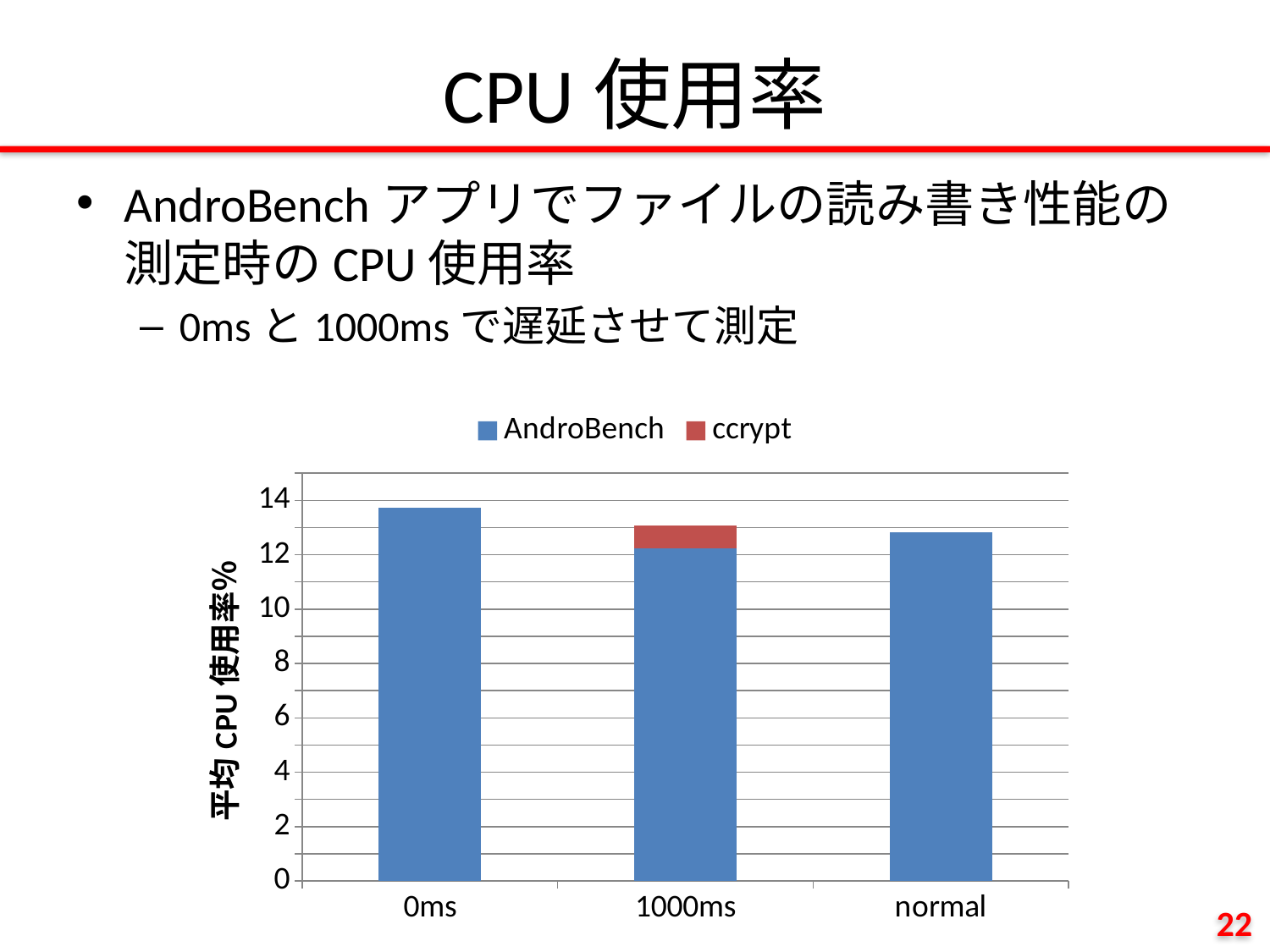
How many categories are shown on the x axis of the chart? 3 Is the AndroBench value for normal greater or less than 14? less Is the AndroBench value for 1000ms greater or less than 10? greater In which category is a ccrypt segment visible in the stacked bar? 1000ms Which series is shown in red in the chart? ccrypt Which is larger, the AndroBench value for 0ms or for normal? 0ms What is the label of the y axis? 平均 CPU 使用率% What kind of chart is shown on the slide? bar chart Which category has the highest AndroBench value? 0ms How many series does the chart's legend list? 2 Which category has the lowest AndroBench value? 1000ms Is the AndroBench value for 0ms greater or less than 12? greater